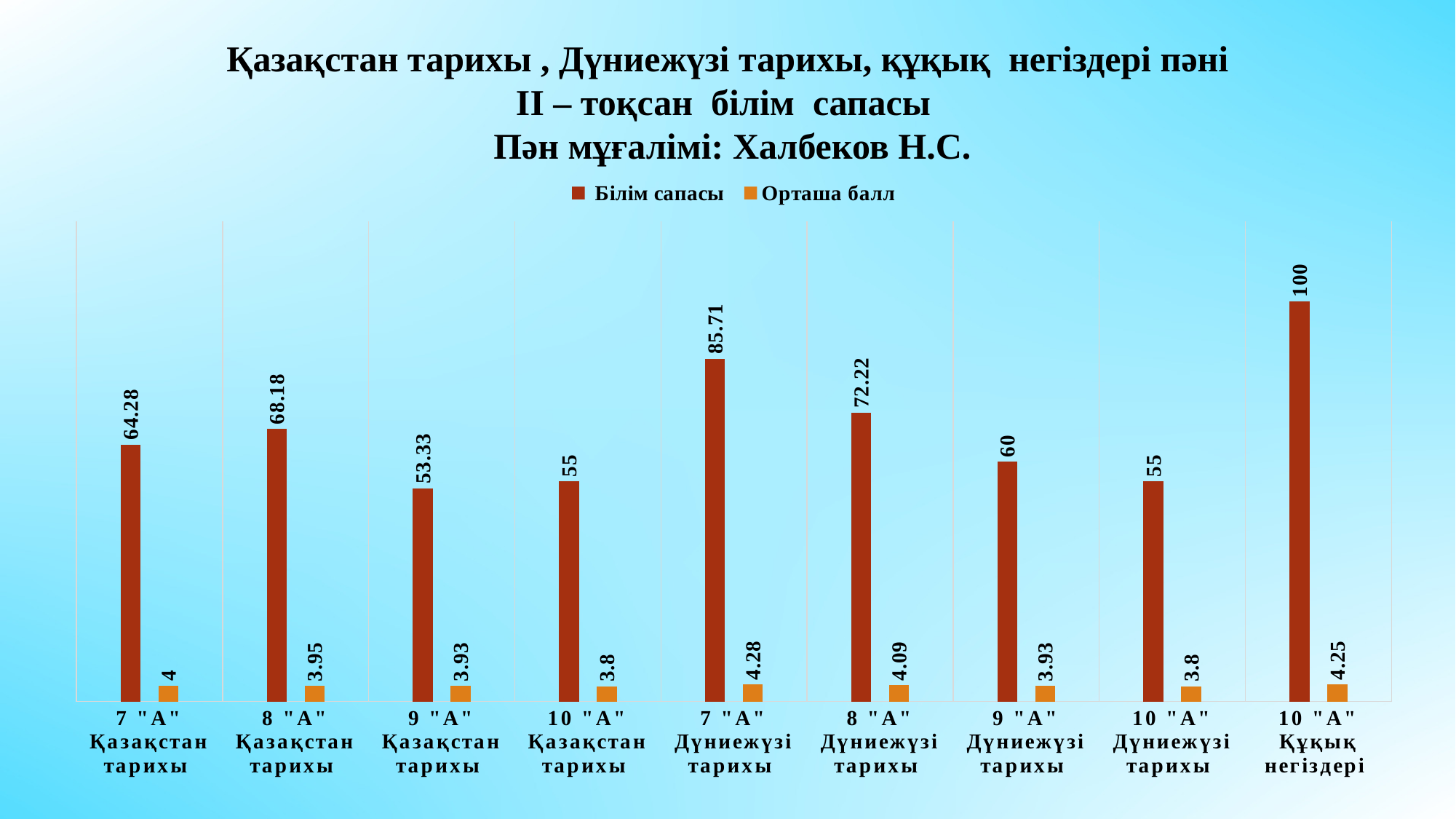
What is the Білім сапасы value for 7 "А" Қазақстан тарихы? 64.28 Which series is shown in orange in the legend? Орташа балл How many series does the legend list? 2 How many categories are shown on the x axis? 9 Which category has the lowest Білім сапасы value? 9 "А" Қазақстан тарихы Which is larger: the Білім сапасы value for 8 "А" Қазақстан тарихы or for 9 "А" Дүниежүзі тарихы? 8 "А" Қазақстан тарихы What is the Білім сапасы value for 9 "А" Қазақстан тарихы? 53.33 What is the difference between the Білім сапасы values for 7 "А" Дүниежүзі тарихы and 8 "А" Дүниежүзі тарихы? 13.49 What is the Орташа балл value for 8 "А" Дүниежүзі тарихы? 4.09 What kind of chart is shown on the slide? Bar chart Which category has the highest Білім сапасы value? 10 "А" Құқық негіздері Which category has the highest Орташа балл value? 7 "А" Дүниежүзі тарихы